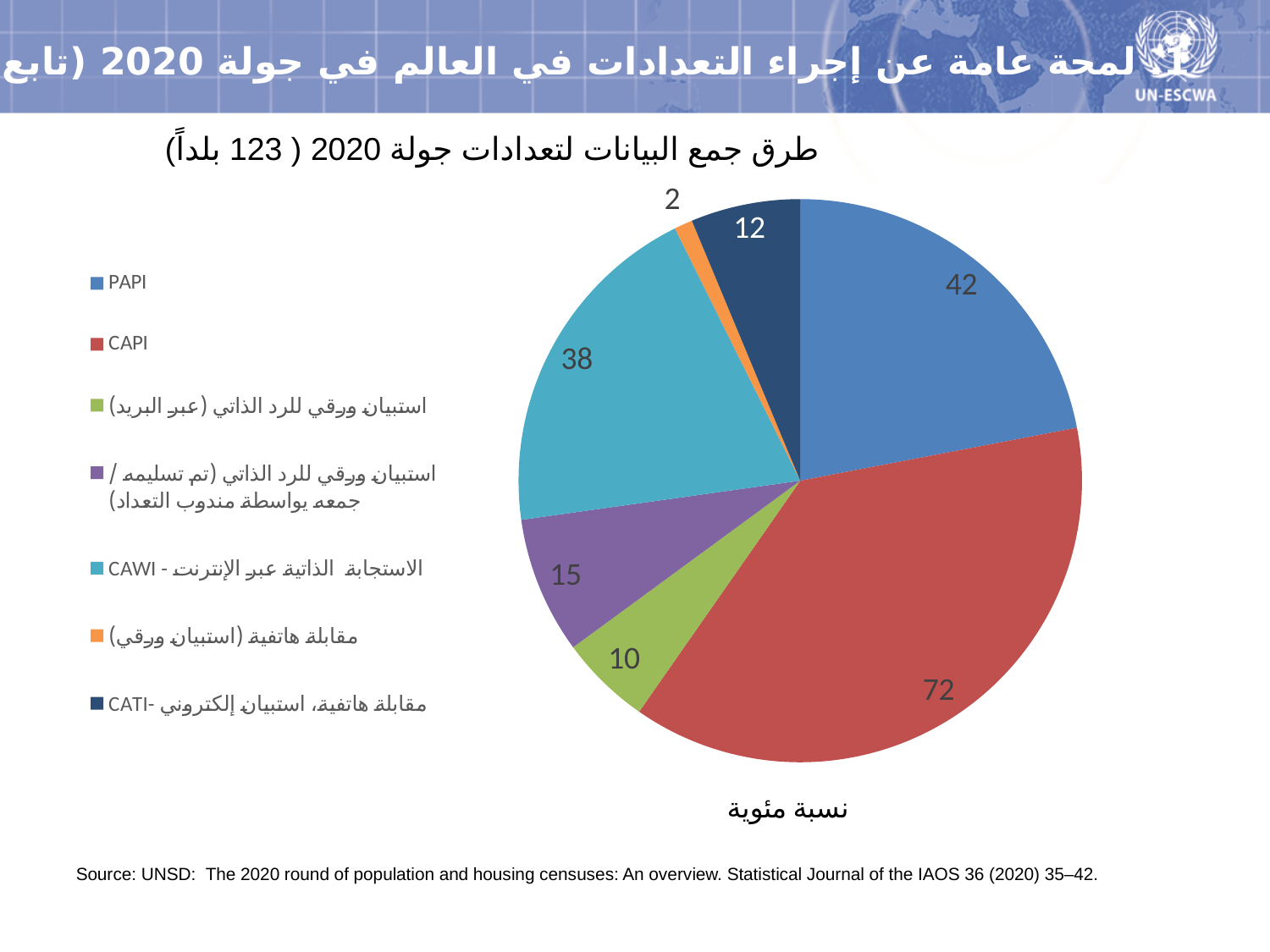
Which data collection method has the largest slice in the pie chart? CAPI What is the difference between the values for CAPI and PAPI? 30 How many slices does the pie chart have? 7 Which is larger, the value for CAWI or the value for CATI? CAWI What is the value for CAWI (الاستجابة الذاتية عبر الإنترنت) in the pie chart? 38 How many countries does the chart title say the data covers? 123 What is the value for مقابلة هاتفية (استبيان ورقي) in the pie chart? 2 What type of chart is shown on the slide? pie chart What is the value for CAPI in the pie chart? 72 What is the value for PAPI in the pie chart? 42 Which data collection method has the smallest slice in the pie chart? مقابلة هاتفية (استبيان ورقي) What is the value for CATI (مقابلة هاتفية، استبيان إلكتروني) in the pie chart? 12